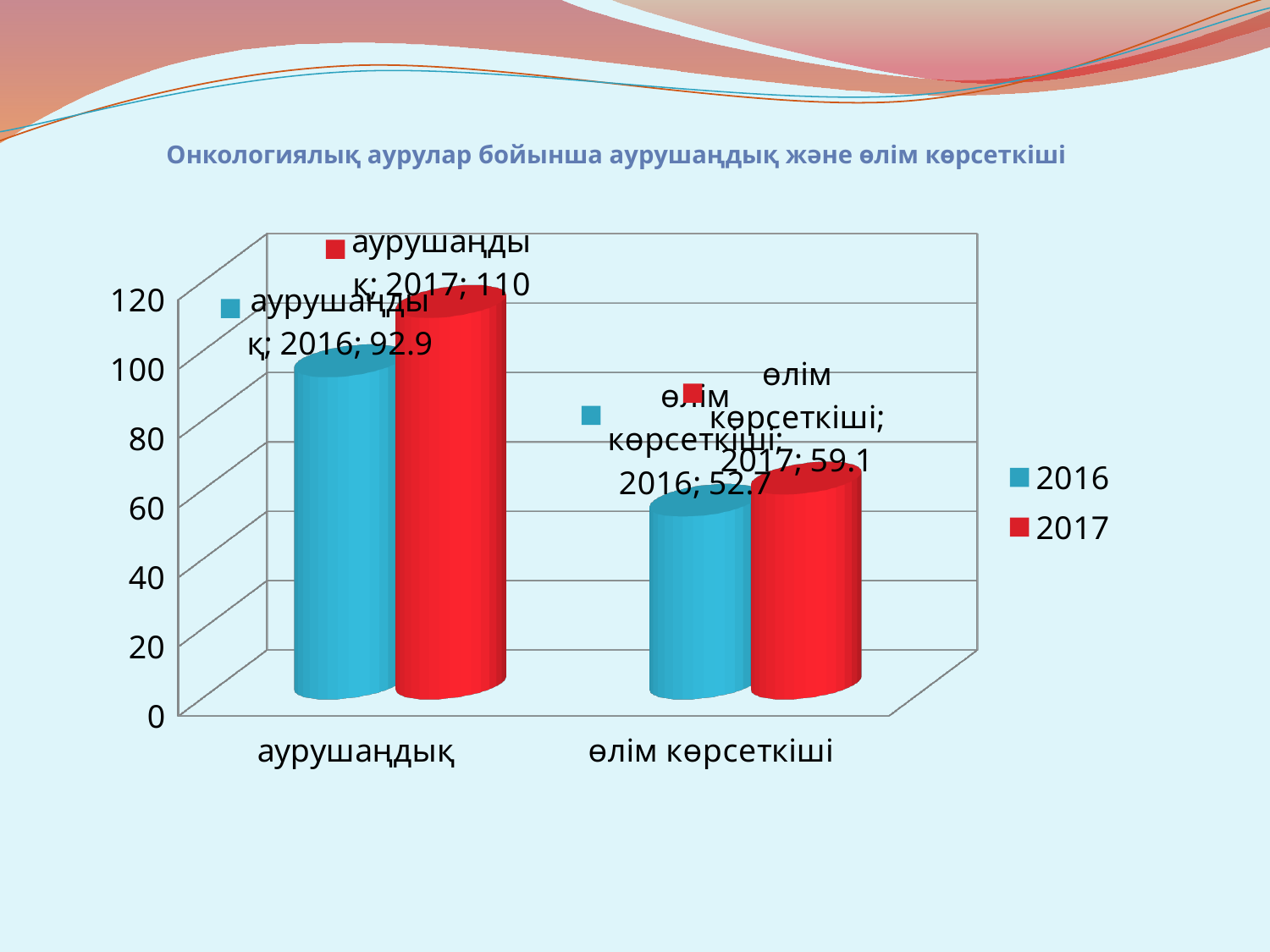
How many categories are shown on the x axis? 2 What is the value for аурушаңдық in 2016? 92.9 What is the value for өлім көрсеткіші in 2016? 52.7 Which category has the highest value in 2017? аурушаңдық What is the value for аурушаңдық in 2017? 110 What kind of chart is shown on the slide? bar chart Which is larger: the 2016 value for аурушаңдық or the 2017 value for өлім көрсеткіші? the 2016 value for аурушаңдық What is the difference between the 2017 and 2016 values for аурушаңдық? 17.1 Which category has the lowest value in 2016? өлім көрсеткіші How many series does the legend list? 2 What is the value for өлім көрсеткіші in 2017? 59.1 What is the difference between the 2017 and 2016 values for өлім көрсеткіші? 6.4